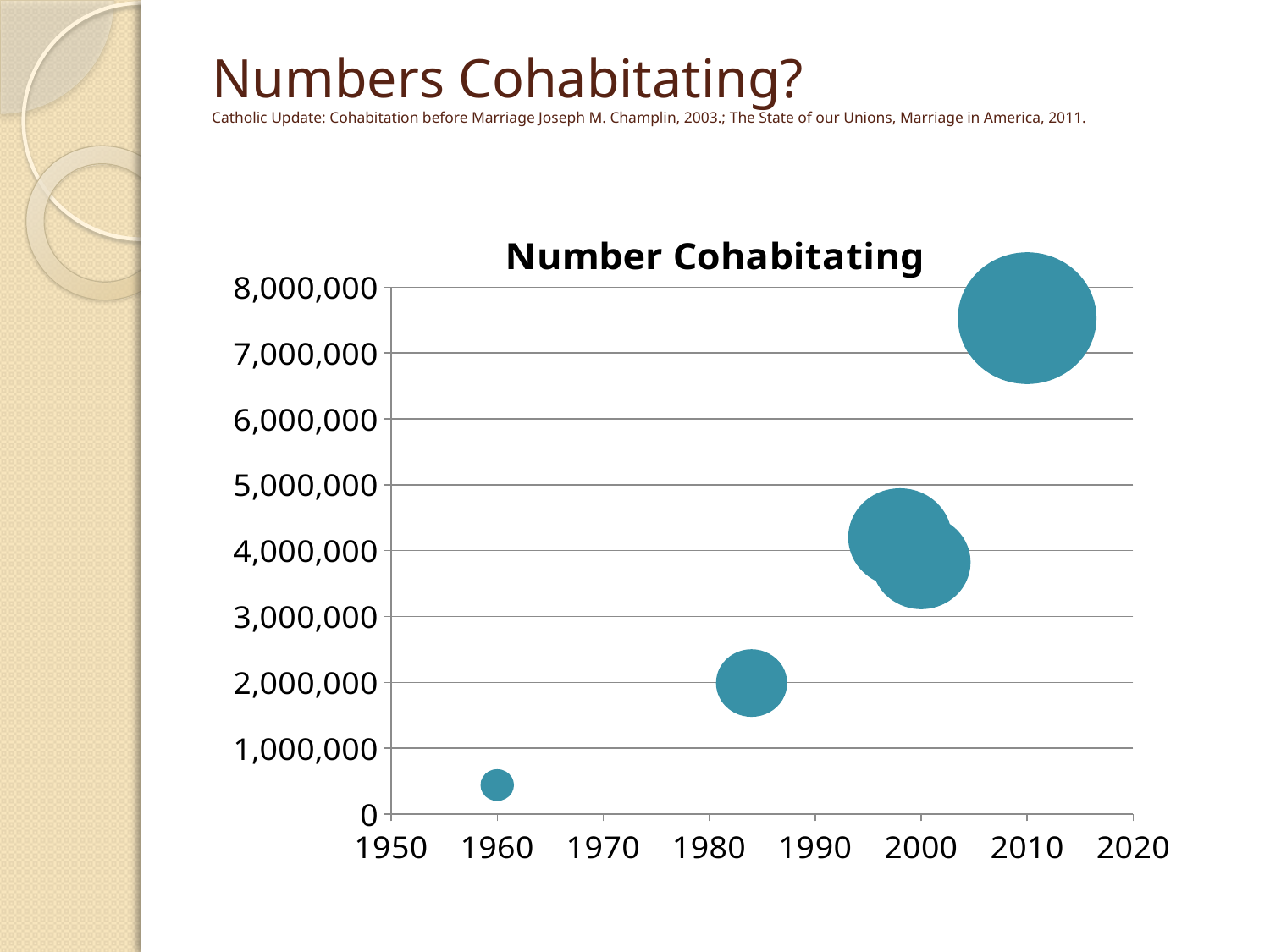
Which is larger, the value for the bubble at 2010 or the bubble near 1984? 2010 Is the value for the largest bubble near 2000 greater or less than 3,000,000? greater What is the highest value shown on the y axis? 8,000,000 Which year's bubble has the highest value? 2010 What kind of chart is shown on the slide? bubble chart Which year's bubble has the lowest value? 1960 Is the value for the bubble at 2010 greater or less than 8,000,000? less Is the value for the bubble at 2010 greater or less than 7,000,000? greater What is the title of the chart? Number Cohabitating Do the values rise or fall as the years increase along the x axis? rise